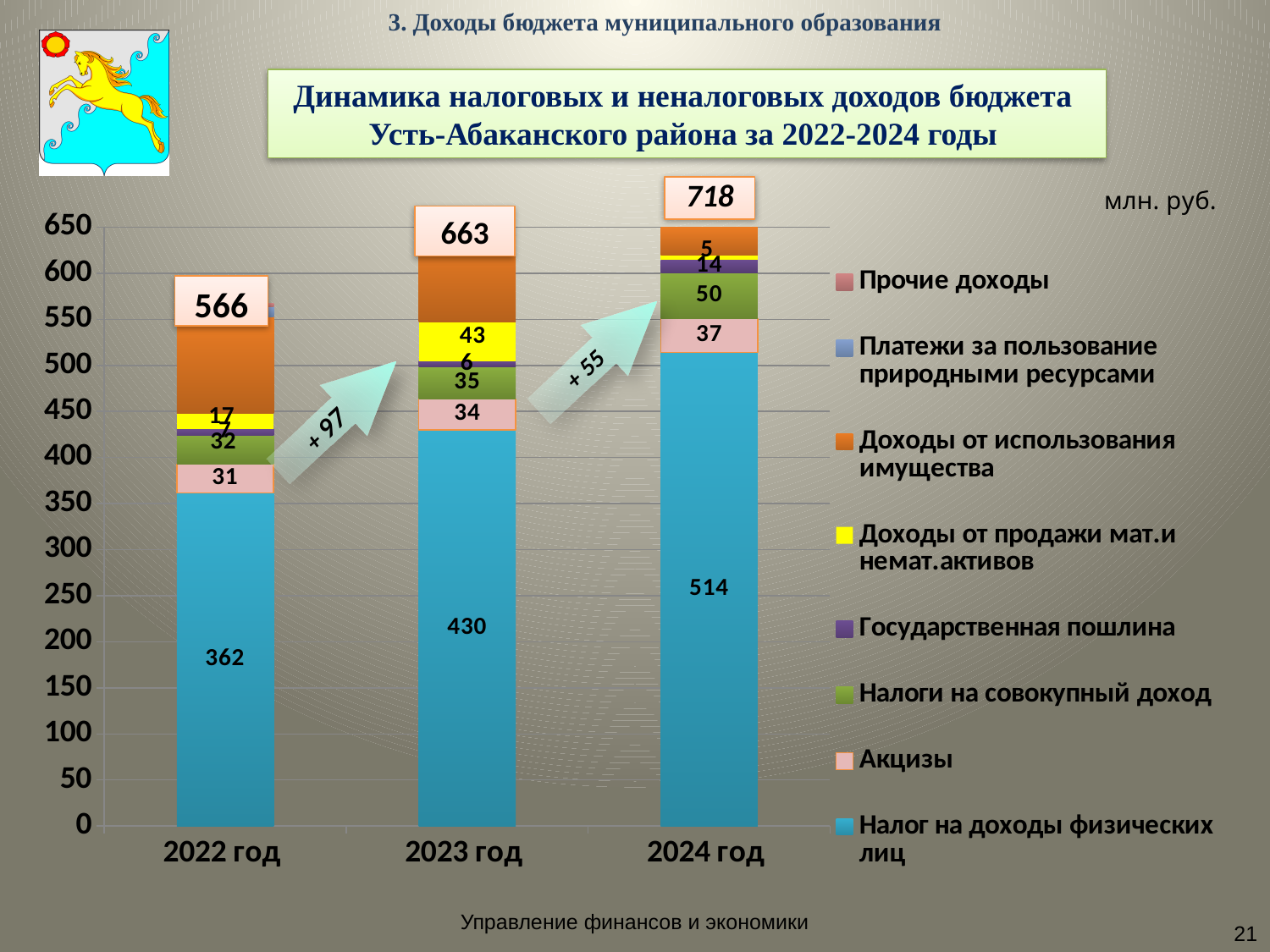
What is the total of the stacked bar for 2022 год? 566 How many series does the legend list? 8 What is the value for Налог на доходы физических лиц in 2022 год? 362 What is the value for Налог на доходы физических лиц in 2024 год? 514 Which year has the lowest total income? 2022 год What is the value for Акцизы in 2023 год? 34 What is the value for Налоги на совокупный доход in 2024 год? 50 Do the total values rise or fall from 2022 год to 2024 год? rise What is the total of the stacked bar for 2024 год? 718 Which is larger, Налоги на совокупный доход in 2022 год or in 2023 год? 2023 год What is the difference between the Налог на доходы физических лиц values for 2024 год and 2022 год? 152 Which year has the highest total income? 2024 год